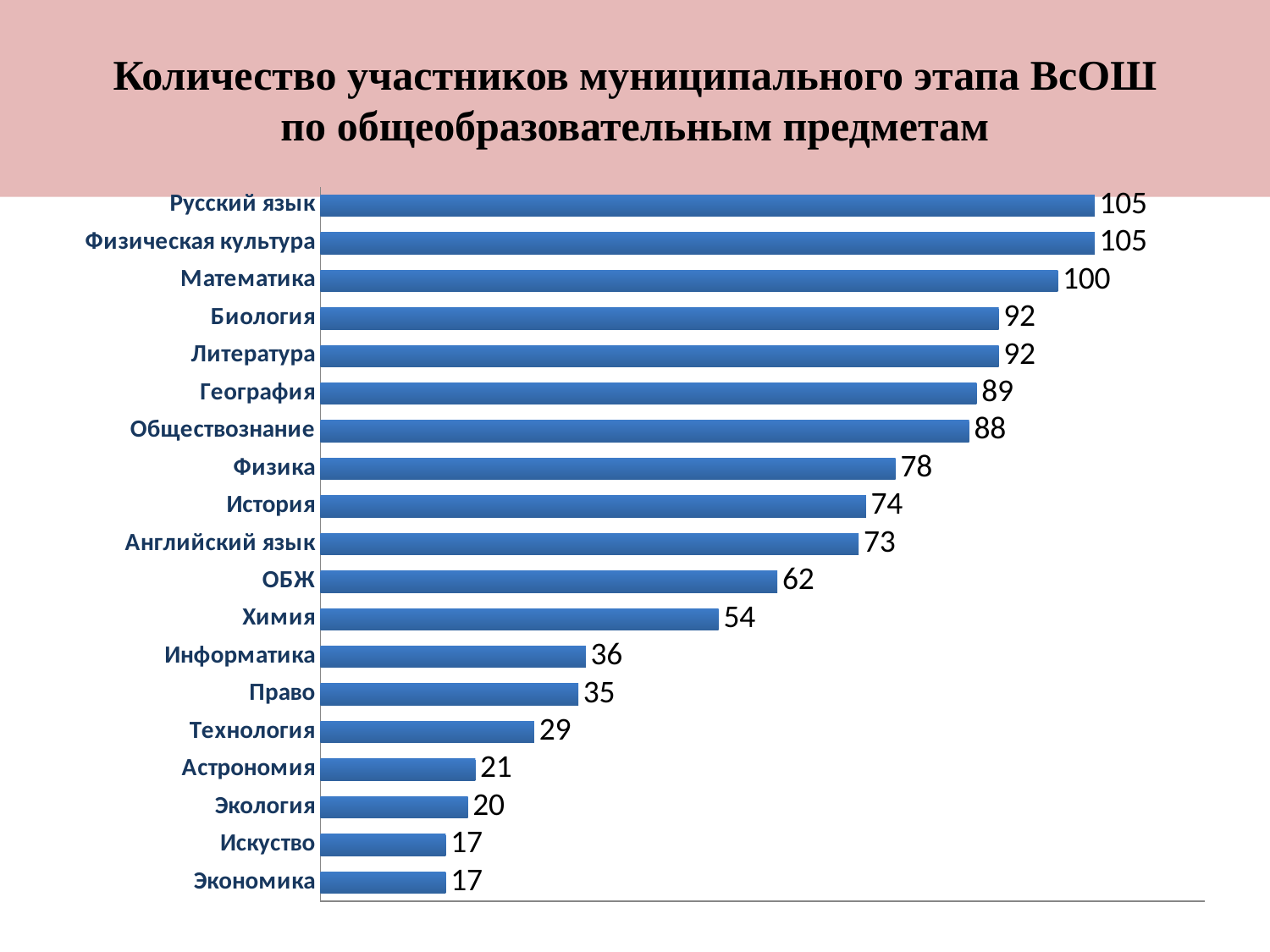
What is the difference between the values for Физика and История? 4 How many subjects (categories) are shown in the chart? 19 Which has a larger value, ОБЖ or Информатика? ОБЖ What is the difference between the values for Русский язык and Экономика? 88 Which has a larger value, Технология or Английский язык? Английский язык Which two subjects share the highest value of 105? Русский язык and Физическая культура What is the title of the chart on the slide? Количество участников муниципального этапа ВсОШ по общеобразовательным предметам What is the value for Математика? 100 What is the value for Астрономия? 21 What kind of chart is shown on the slide? bar chart What is the value for Химия? 54 What is the value for Обществознание? 88